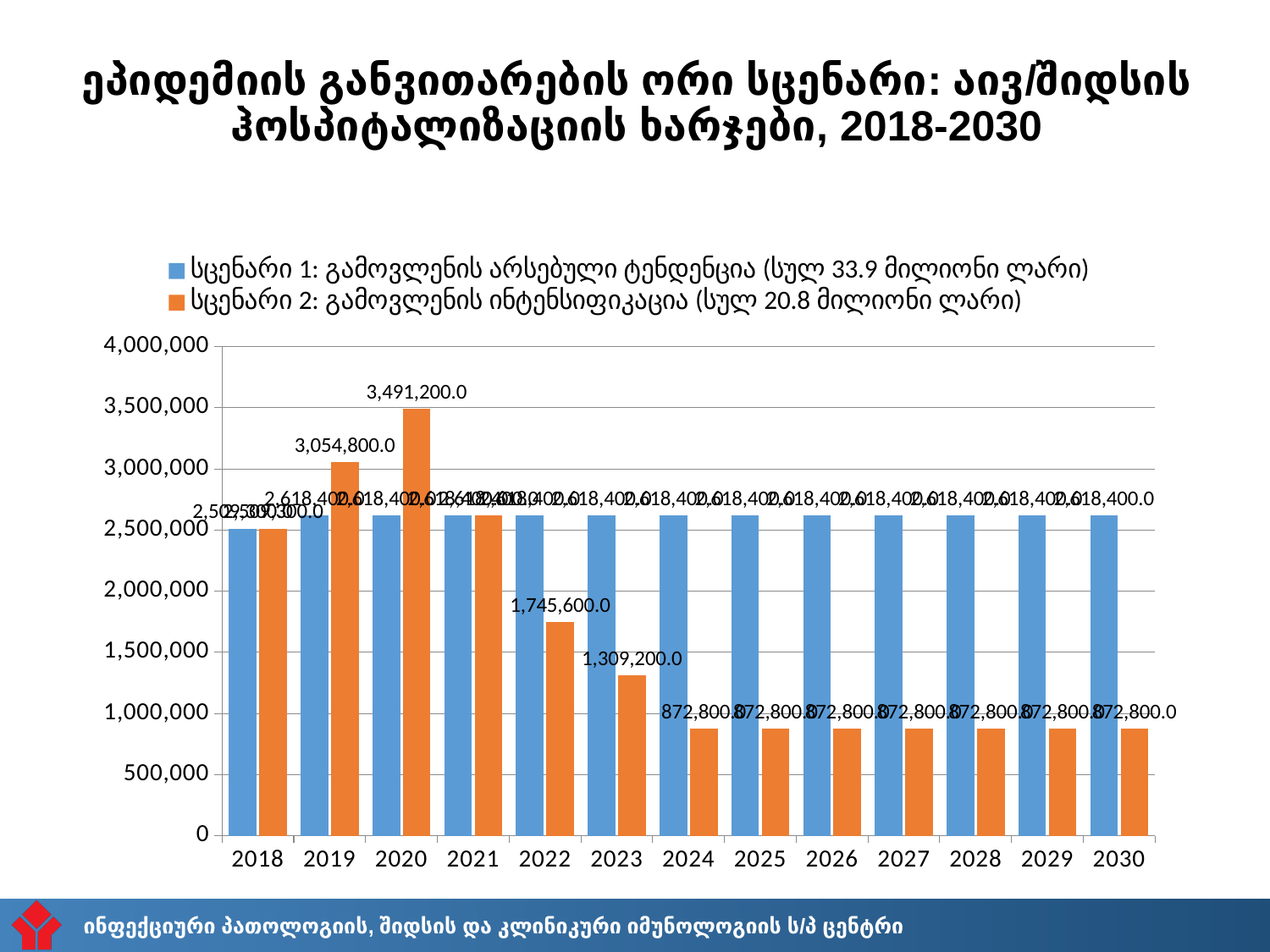
What is the value of the orange series (სცენარი 2) for 2020? 3,491,200.0 What is the difference between the blue and orange series values in 2024? 1,745,600.0 In which year is the orange series (სცენარი 2) highest? 2020 What is the value of the blue series (სცენარი 1) for 2028? 2,618,400.0 In 2023, which series has the larger value, blue (სცენარი 1) or orange (სცენარი 2)? blue (სცენარი 1) Is the value of the blue series for 2025 greater or less than 2,500,000? greater What is the value of the orange series (სცენარი 2) for 2023? 1,309,200.0 Does the orange series rise or fall from 2020 to 2030? fall What is the difference between the orange series values for 2020 and 2019? 436,400.0 What is the value of the orange series (სცენარი 2) for 2027? 872,800.0 How many years are shown on the x axis? 13 What is the value of the orange series (სცენარი 2) for 2019? 3,054,800.0